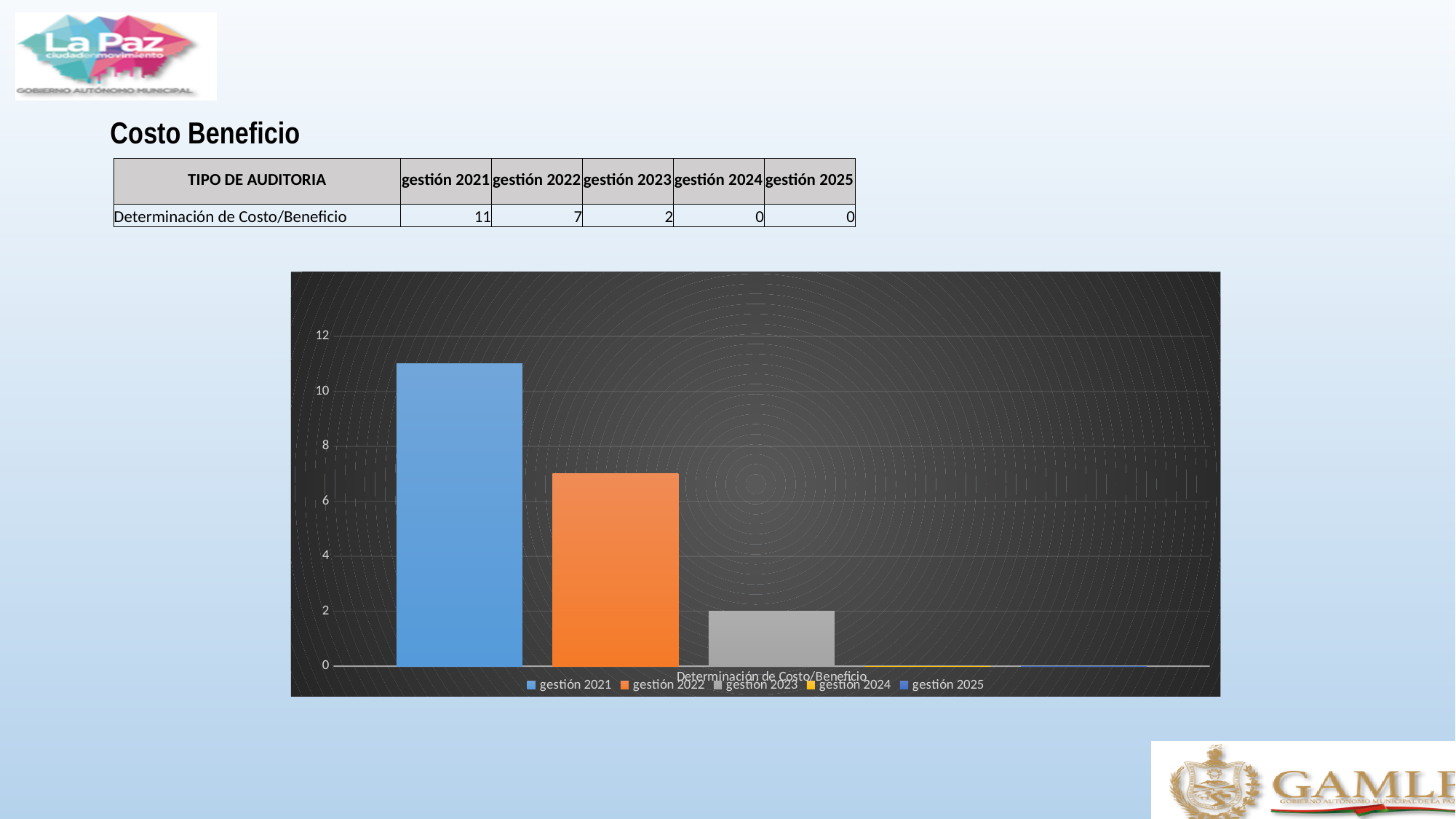
What is the value for gestión 2024 for Determinación de Costo/Beneficio? 0 What is the difference between the gestión 2021 and gestión 2022 values? 4 What type of chart is shown on the slide? bar chart Which series has the highest value in the chart? gestión 2021 What is the value for gestión 2023 for Determinación de Costo/Beneficio? 2 What is the value for gestión 2021 for Determinación de Costo/Beneficio? 11 Which is larger, the value for gestión 2022 or the value for gestión 2023? gestión 2022 Do the values rise or fall from gestión 2021 to gestión 2025? fall Is the value for gestión 2021 greater or less than 10? greater What colour is the bar for gestión 2022? orange How many series does the chart legend list? 5 What is the value for gestión 2022 for Determinación de Costo/Beneficio? 7